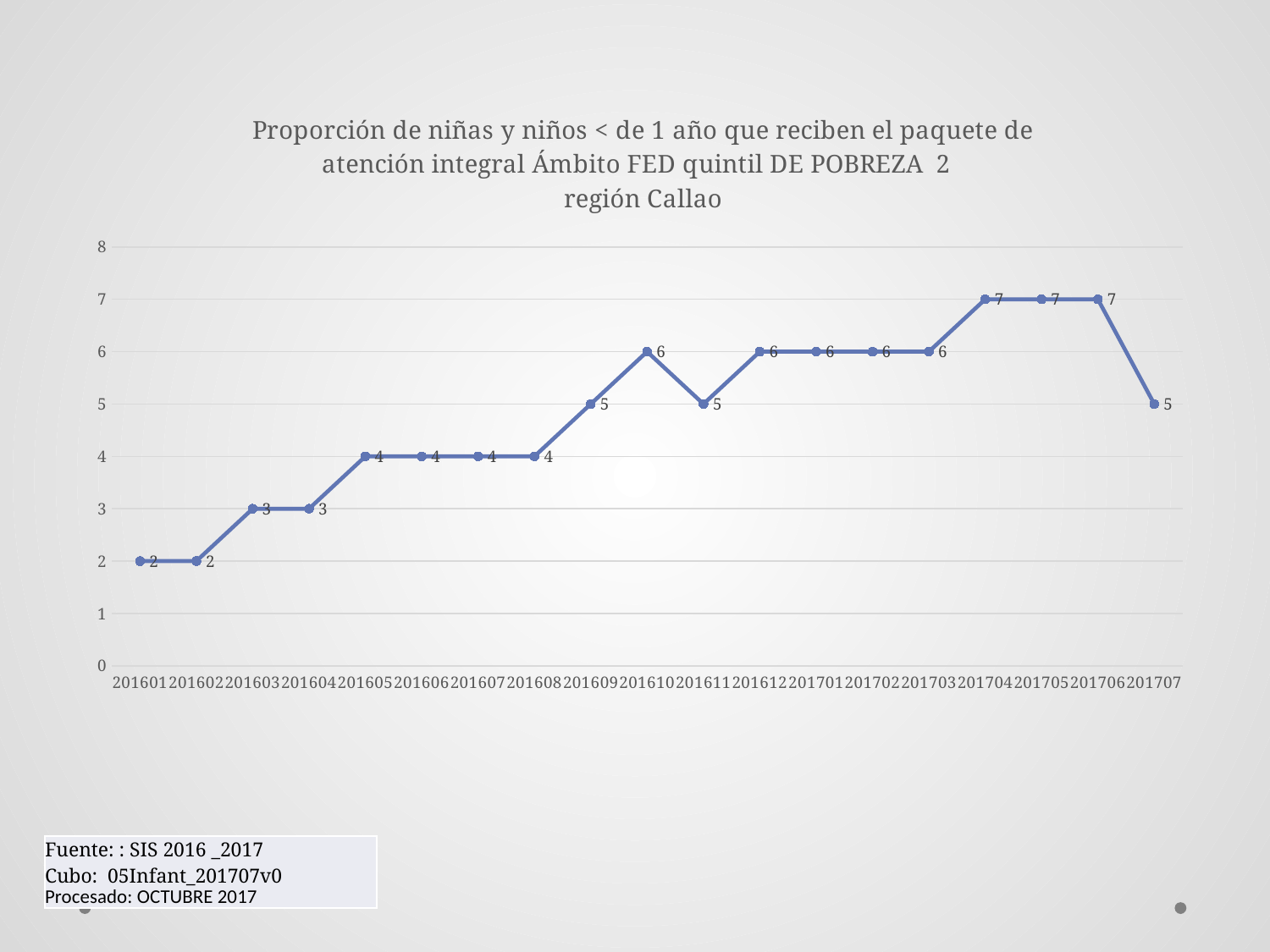
What kind of chart is shown on the slide? Line chart Which is larger, the value for 201603 or the value for 201612? 201612 Which is larger, the value for 201609 or the value for 201611? They are equal (5) What is the value for 201707? 5 Do the values generally rise or fall from 201601 to 201706? Rise What is the value for 201601? 2 What is the lowest value plotted on the chart? 2 What is the value for 201704? 7 What is the difference between the values for 201706 and 201707? 2 How many data points are plotted on the chart? 19 What is the value for 201610? 6 What is the highest value plotted on the chart? 7